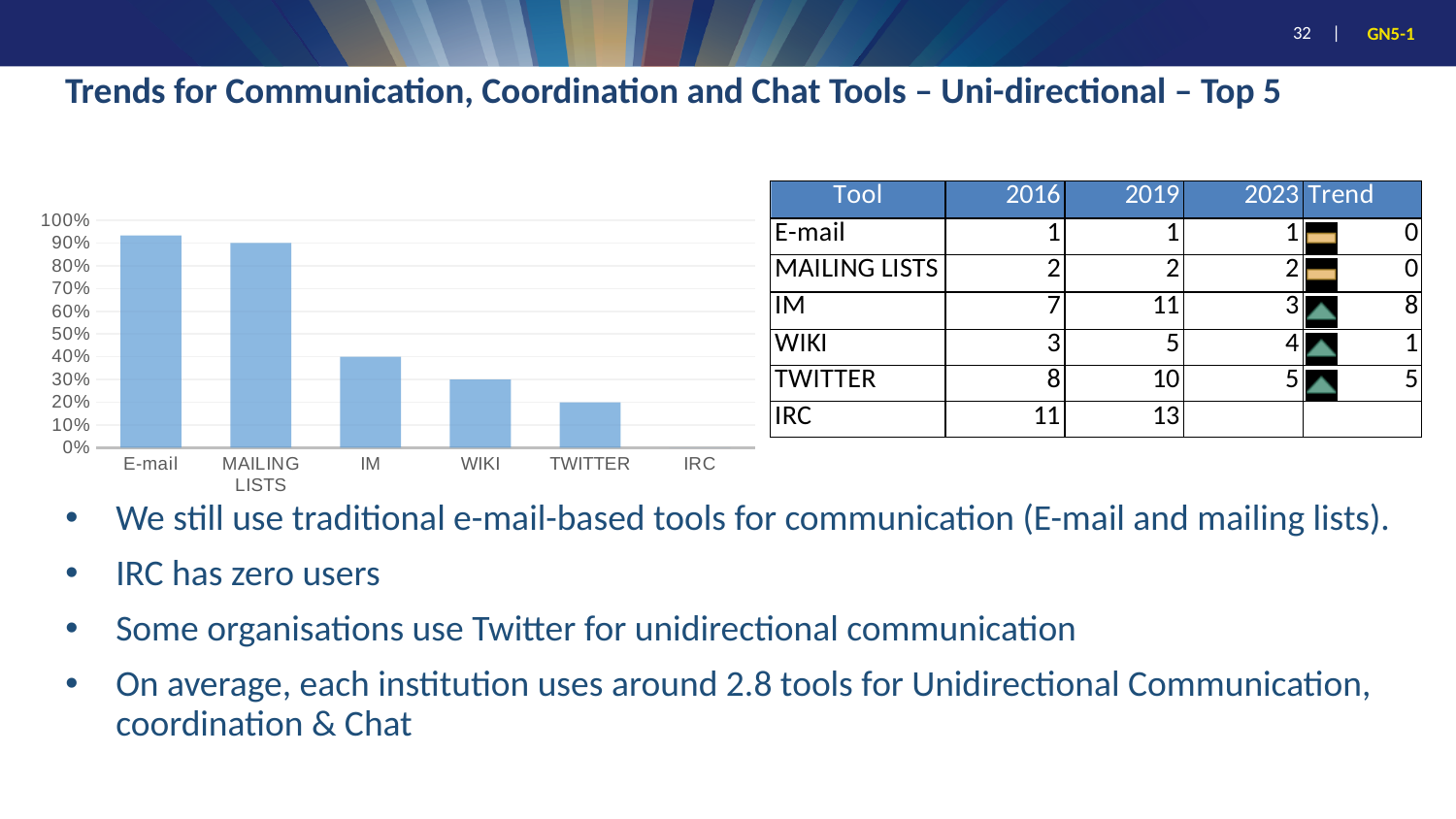
Is the value for WIKI greater or less than 40%? less What colour are the bars in the chart? blue What kind of chart is shown on the slide? bar chart Is the value for TWITTER greater or less than 30%? less What is the value for IRC in the bar chart? 0% Is the value for MAILING LISTS greater or less than 80%? greater Which is larger in the bar chart, the value for IM or the value for WIKI? IM How many categories are shown on the x axis of the bar chart? 6 Which category has the lowest value in the bar chart? IRC Do the values in the bar chart rise or fall from left to right along the x axis? fall